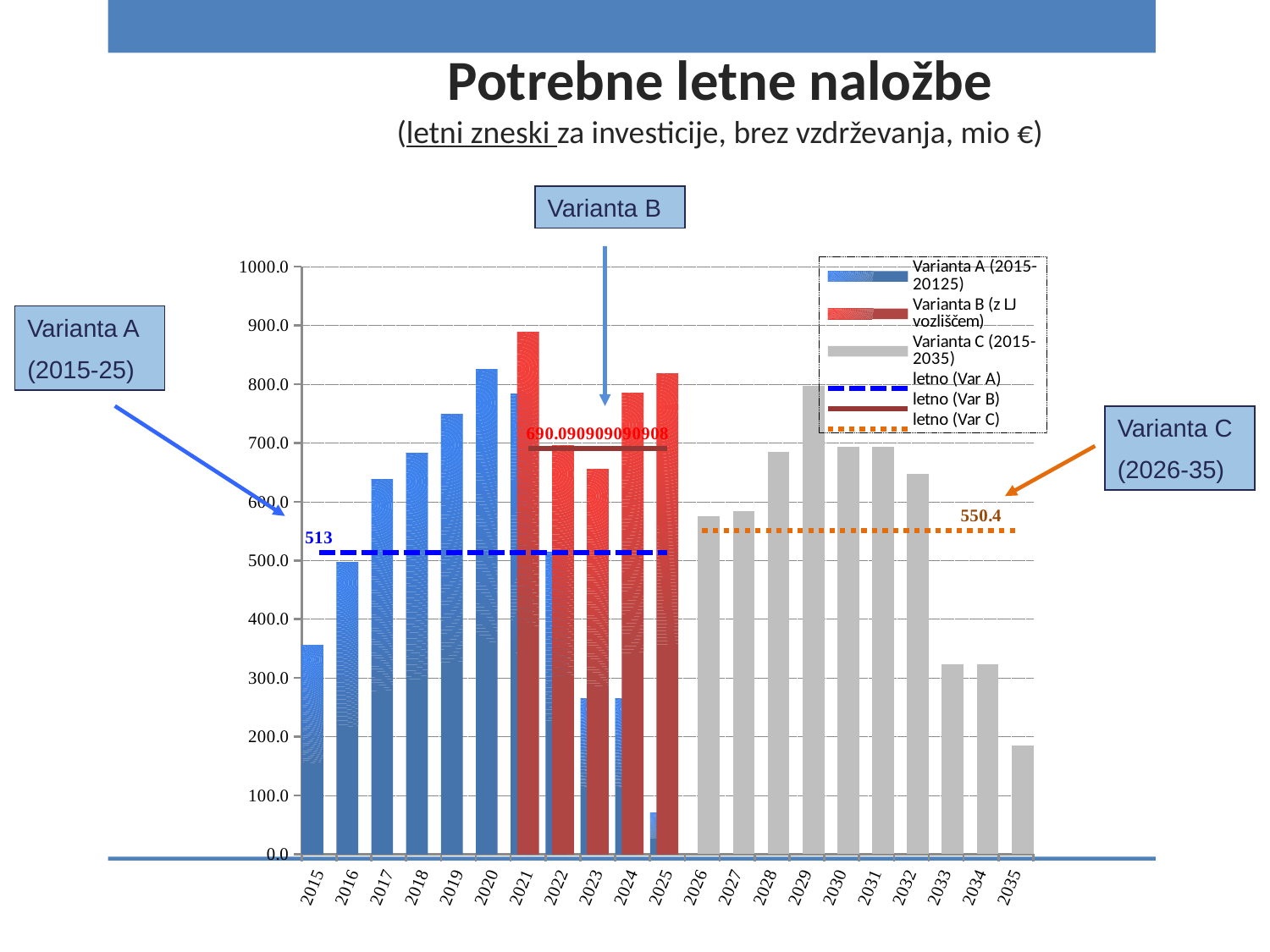
Among the Varianta C bars (2026-2035), which year has the lowest value? 2035 What value is labelled on the dotted line for letno (Var C)? 550.4 What value is labelled on the line for letno (Var B)? 690.090909090908 How many series does the chart legend list? 6 Is the value for 2020 greater or less than 800? greater How many years are shown on the x axis of the chart? 21 Is the value for 2015 greater or less than 400? less What value is labelled on the dashed line for letno (Var A)? 513 Among the Varianta C bars (2026-2035), which year has the highest value? 2029 What kind of chart is shown on the slide? combination bar and line chart What is the title of the chart on the slide? Potrebne letne naložbe